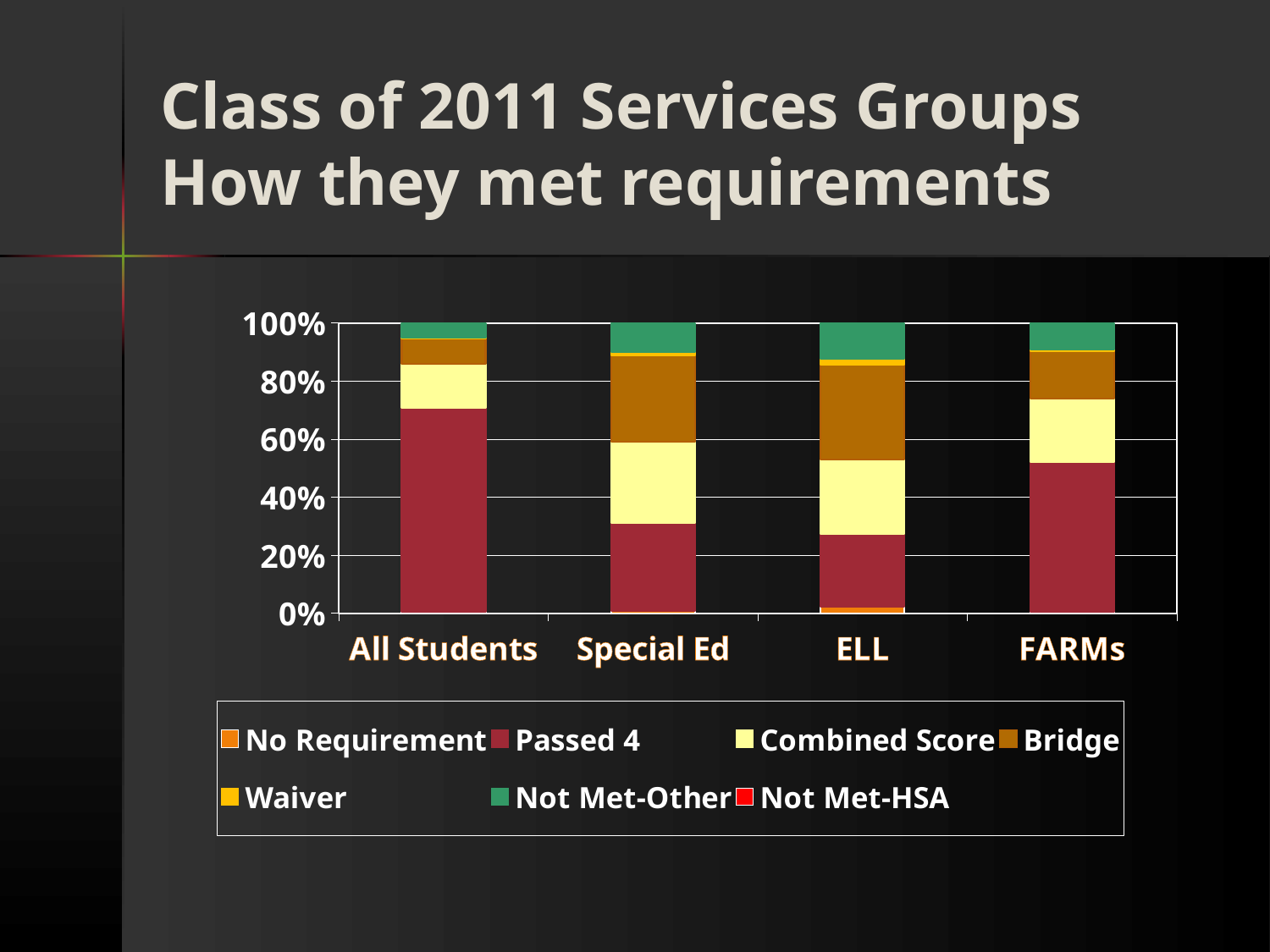
Is the Passed 4 value for FARMs greater or less than 40%? greater Is the Passed 4 value for All Students greater or less than 60%? greater Which group has the smallest Combined Score segment? All Students Is the Passed 4 value for Special Ed greater or less than 40%? less Which group's bar shows a visible No Requirement segment at the bottom? ELL What kind of chart is shown on the slide? Stacked bar chart Which group has the smallest Bridge segment? All Students How many student groups are shown on the x axis? 4 What is the title of the slide containing the chart? Class of 2011 Services Groups How they met requirements Which has a larger Passed 4 segment, Special Ed or FARMs? FARMs How many series does the legend list? 7 Which group has the largest Passed 4 segment? All Students